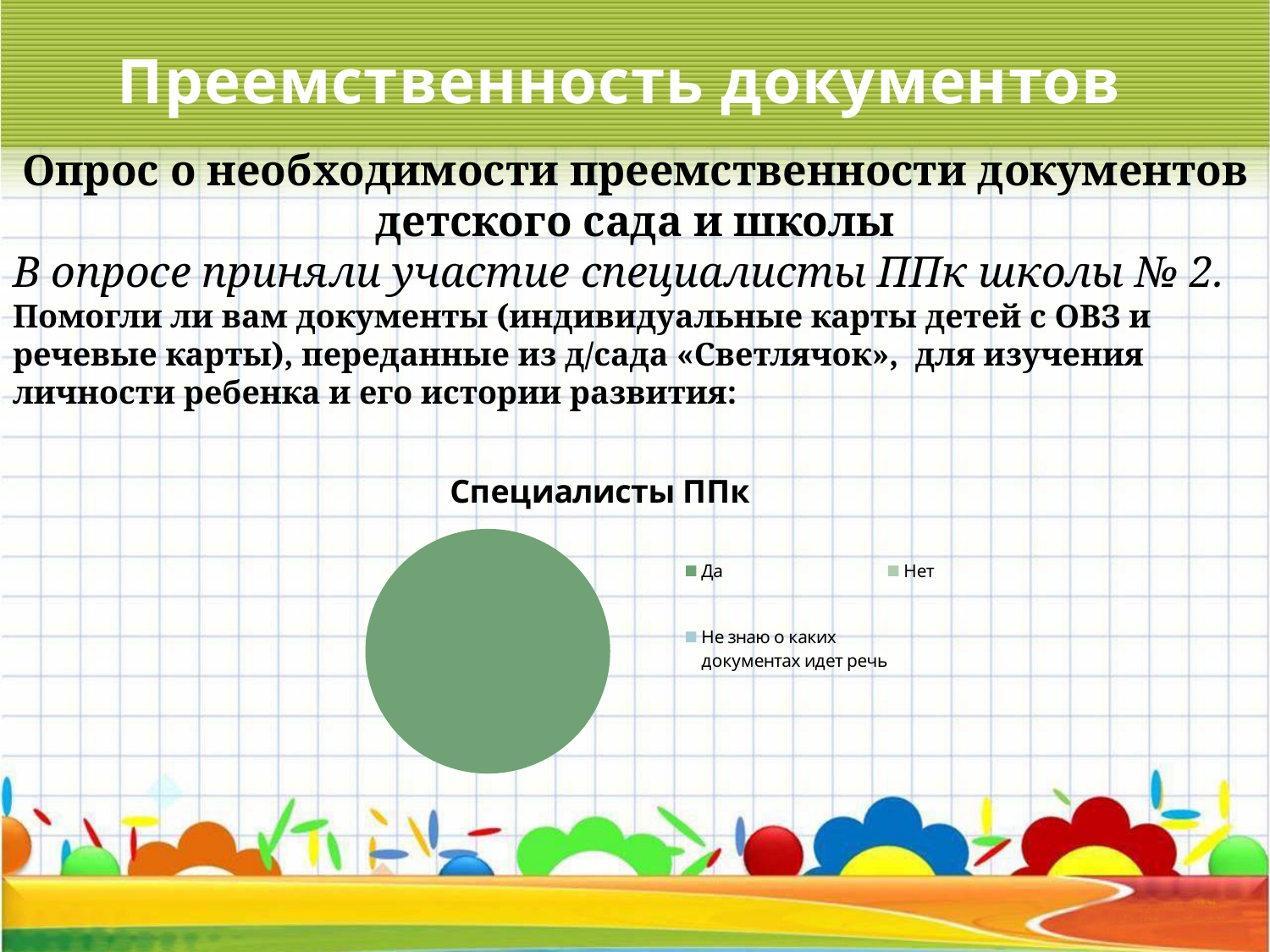
What kind of chart is shown on the slide? pie chart How many entries does the chart's legend list? 3 What is the third legend entry in the chart? Не знаю о каких документах идет речь What is the title of the chart? Специалисты ППк Which category takes up the largest share of the pie? Да Which is larger in the pie chart, the share for Да or the share for Не знаю о каких документах идет речь? Да Which is larger in the pie chart, the share for Да or the share for Нет? Да